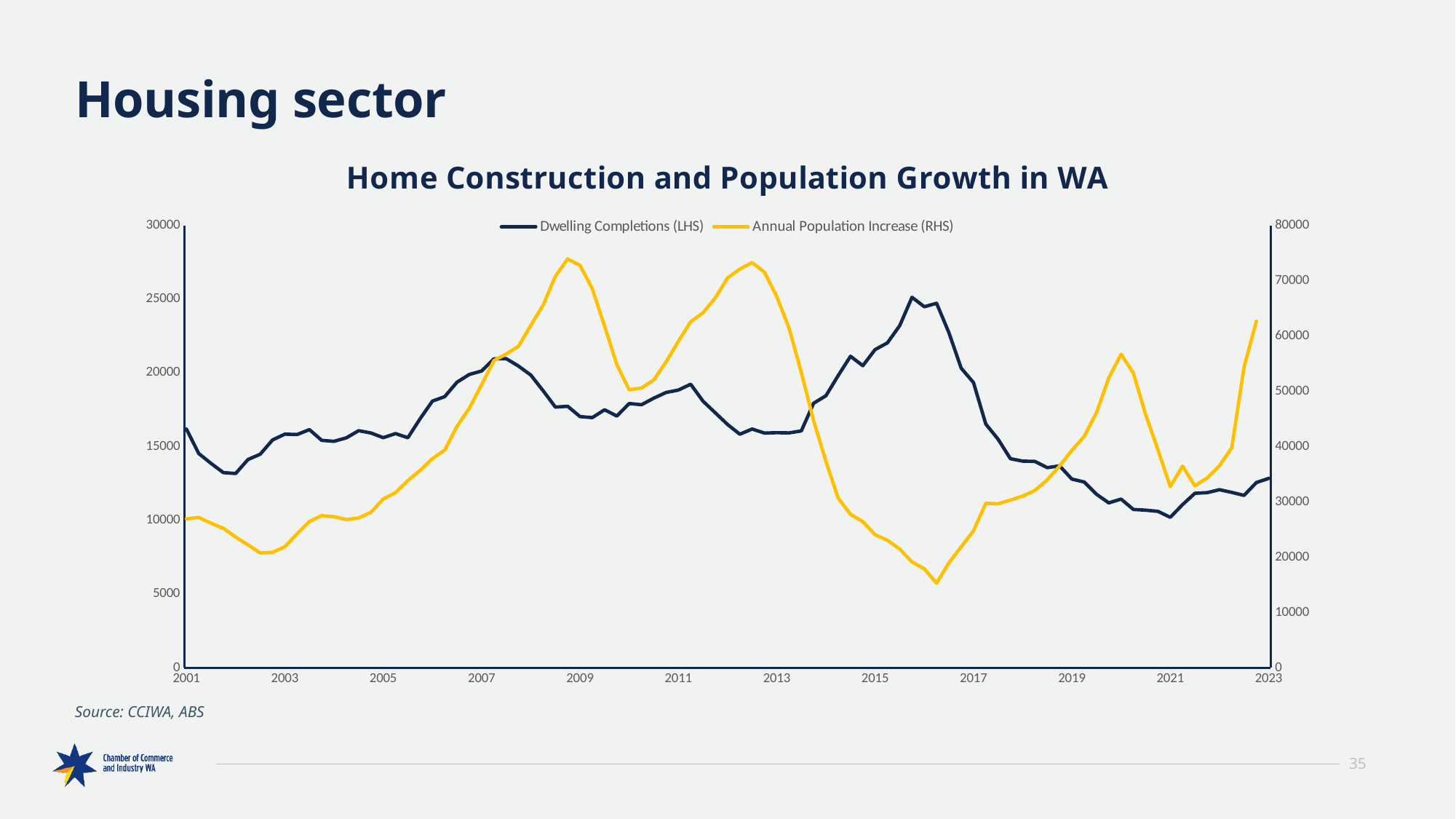
Which is larger for Dwelling Completions: the value in 2015 or the value in 2021? 2015 What is the title of the chart? Home Construction and Population Growth in WA Does the Dwelling Completions series rise or fall between 2016 and 2021? fall How many series does the legend list? 2 Is the value for Dwelling Completions in 2001 greater or less than 15000? greater Which series is drawn in yellow? Annual Population Increase (RHS) What kind of chart is shown on the slide? line chart Is the value for Annual Population Increase in 2001 greater or less than 30000? less Is the value for Annual Population Increase in 2023 greater or less than 50000? greater Does the Annual Population Increase series rise or fall between 2021 and 2023? rise